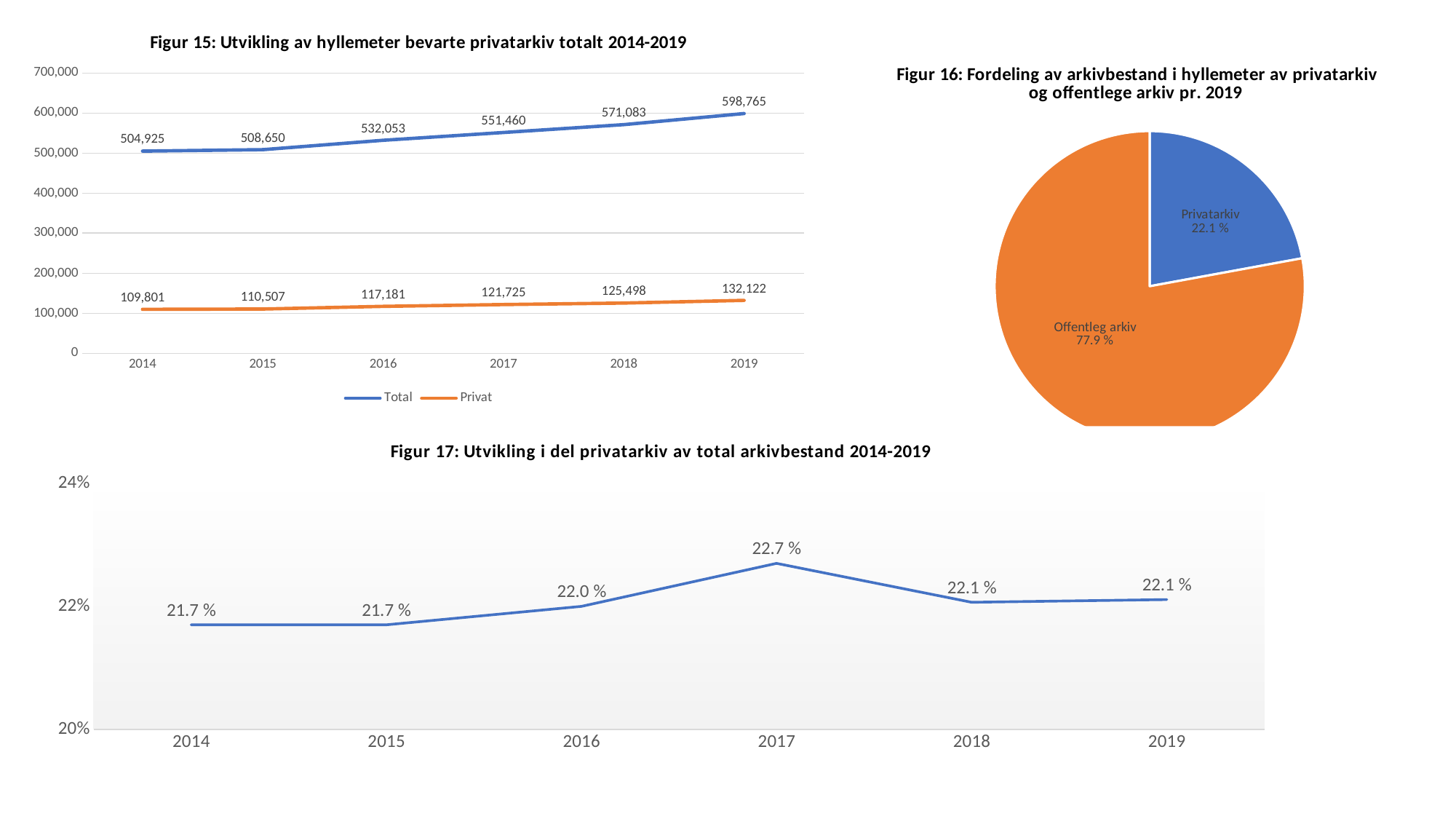
In Figur 15, what type of chart is shown? line chart In Figur 16, what share of the pie is Privatarkiv? 22.1 % In Figur 15, how many series does the legend list? 2 In Figur 16, which slice is larger, Privatarkiv or Offentleg arkiv? Offentleg arkiv In Figur 15, what is the difference between the Total and Privat values in 2014? 395,124 In Figur 15, what is the Total value for 2019? 598,765 In Figur 17, what is the value for 2016? 22.0 % In Figur 17, how many years are plotted on the x axis? 6 In Figur 15, what is the Privat value for 2016? 117,181 In Figur 17, which year has the highest value? 2017 In Figur 15, does the Total series rise or fall from 2014 to 2019? rise In Figur 17, what is the difference between the 2017 value and the 2014 value? 1.0 %